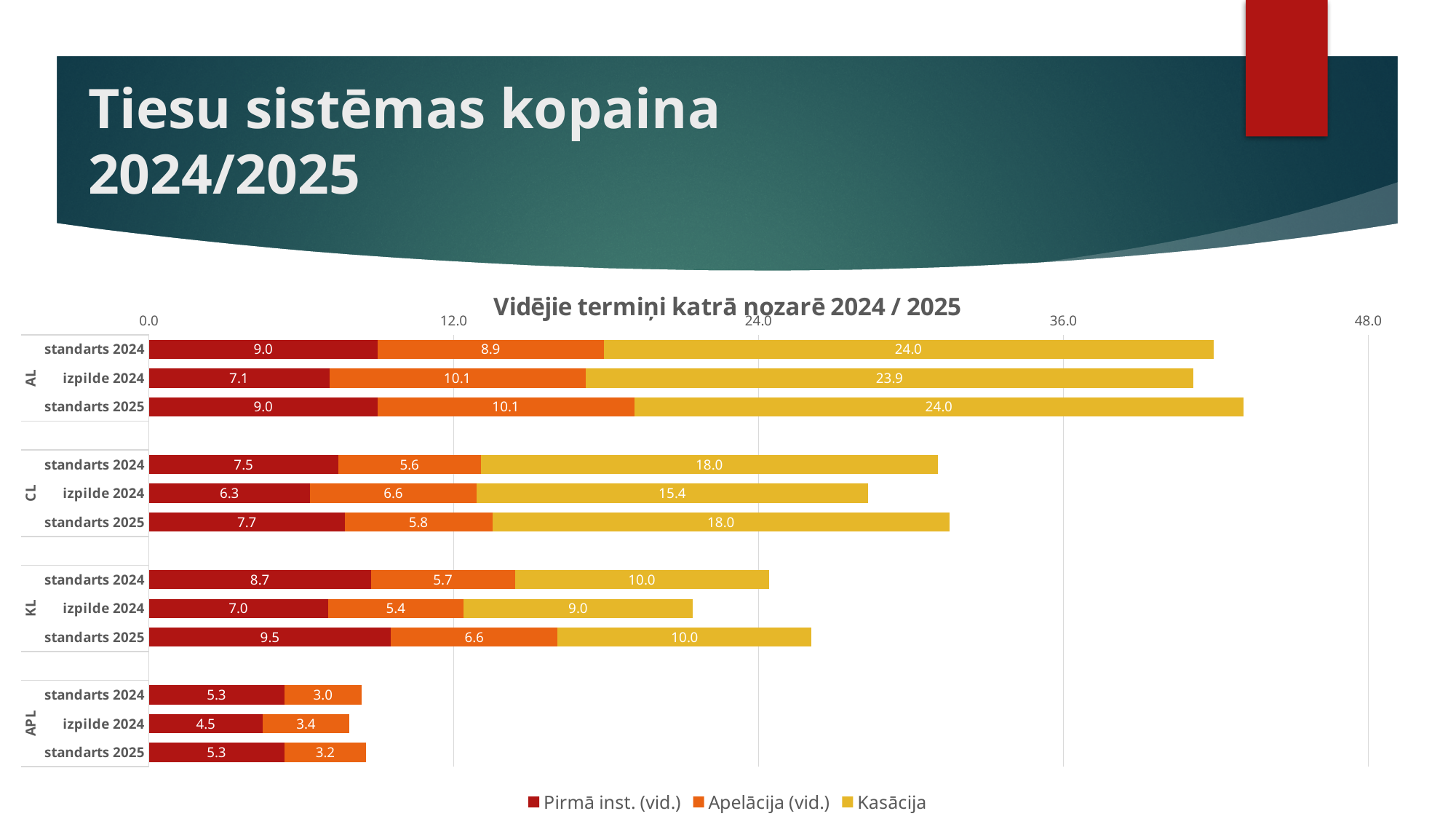
What is the Kasācija value for AL izpilde 2024? 23.9 Which group has the longest stacked bar for standarts 2024? AL Which group has the shortest stacked bar for izpilde 2024? APL What is the title of the chart? Vidējie termiņi katrā nozarē 2024 / 2025 How many series does the legend list? 3 What is the total of the stacked bar for CL izpilde 2024? 28.3 What is the total of the stacked bar for AL standarts 2025? 43.1 What is the difference between the Kasācija values for CL standarts 2024 and CL izpilde 2024? 2.6 What is the Pirmā inst. (vid.) value for KL standarts 2025? 9.5 What kind of chart is shown on the slide? Stacked bar chart Which is larger: the Apelācija (vid.) value for AL izpilde 2024 or for AL standarts 2024? AL izpilde 2024 What is the Apelācija (vid.) value for APL izpilde 2024? 3.4